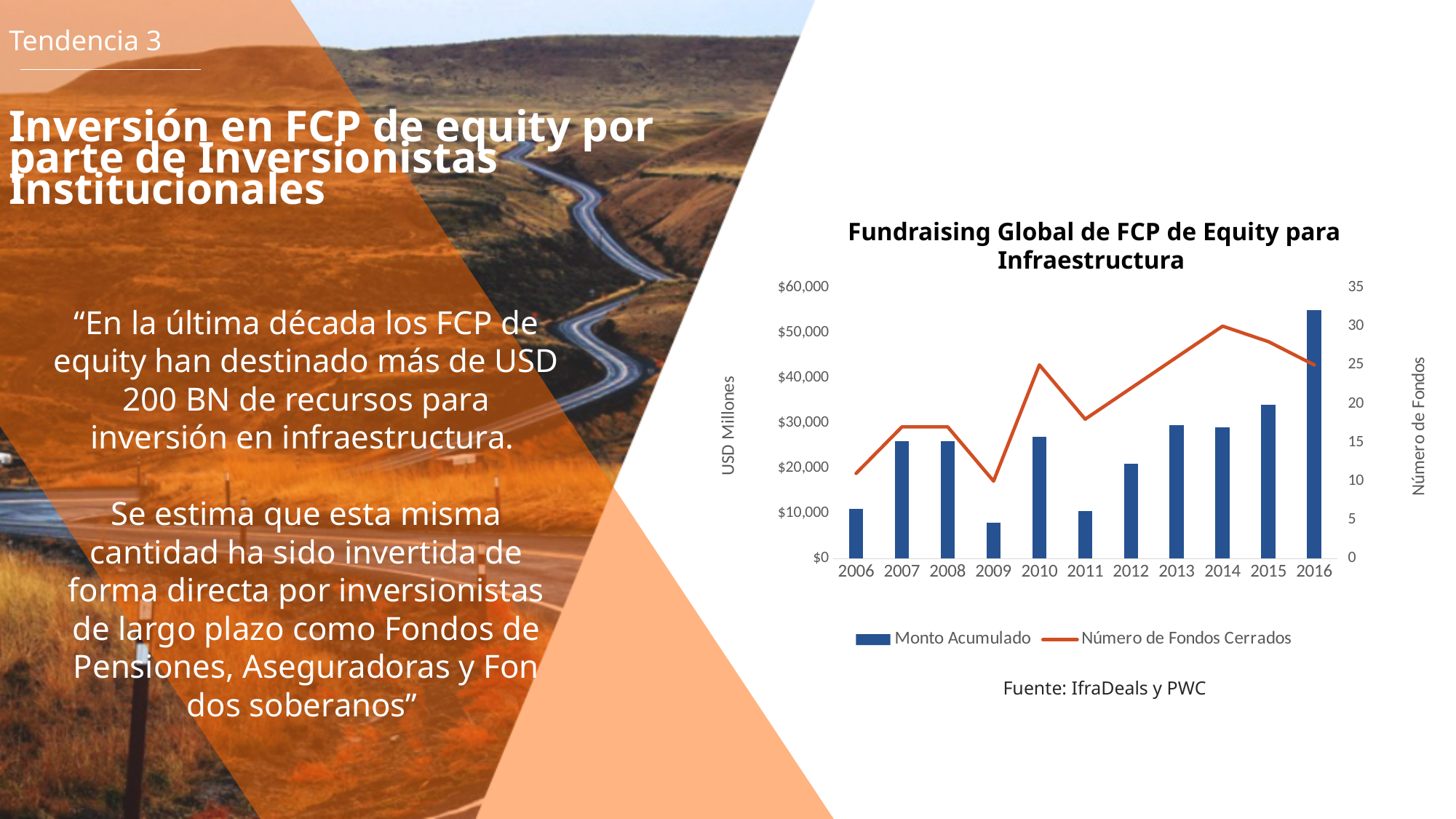
In the chart 'Fundraising Global de FCP de Equity para Infraestructura', which year has the highest Monto Acumulado bar? 2016 In the chart 'Fundraising Global de FCP de Equity para Infraestructura', is the Monto Acumulado for 2009 greater or less than $10,000? less In the chart 'Fundraising Global de FCP de Equity para Infraestructura', which year has the highest Número de Fondos Cerrados? 2014 In the chart 'Fundraising Global de FCP de Equity para Infraestructura', is the Número de Fondos Cerrados for 2014 greater or less than 25? greater How many series does the legend of the chart 'Fundraising Global de FCP de Equity para Infraestructura' list? 2 How many years are shown on the x axis of the chart 'Fundraising Global de FCP de Equity para Infraestructura'? 11 What is the label of the left vertical axis in the chart 'Fundraising Global de FCP de Equity para Infraestructura'? USD Millones In the chart 'Fundraising Global de FCP de Equity para Infraestructura', which year has the lowest Monto Acumulado bar? 2009 In the chart 'Fundraising Global de FCP de Equity para Infraestructura', is the Monto Acumulado for 2015 greater or less than $30,000? greater In the chart 'Fundraising Global de FCP de Equity para Infraestructura', which year has a larger Monto Acumulado, 2012 or 2013? 2013 In the chart 'Fundraising Global de FCP de Equity para Infraestructura', which year has the lowest Número de Fondos Cerrados? 2009